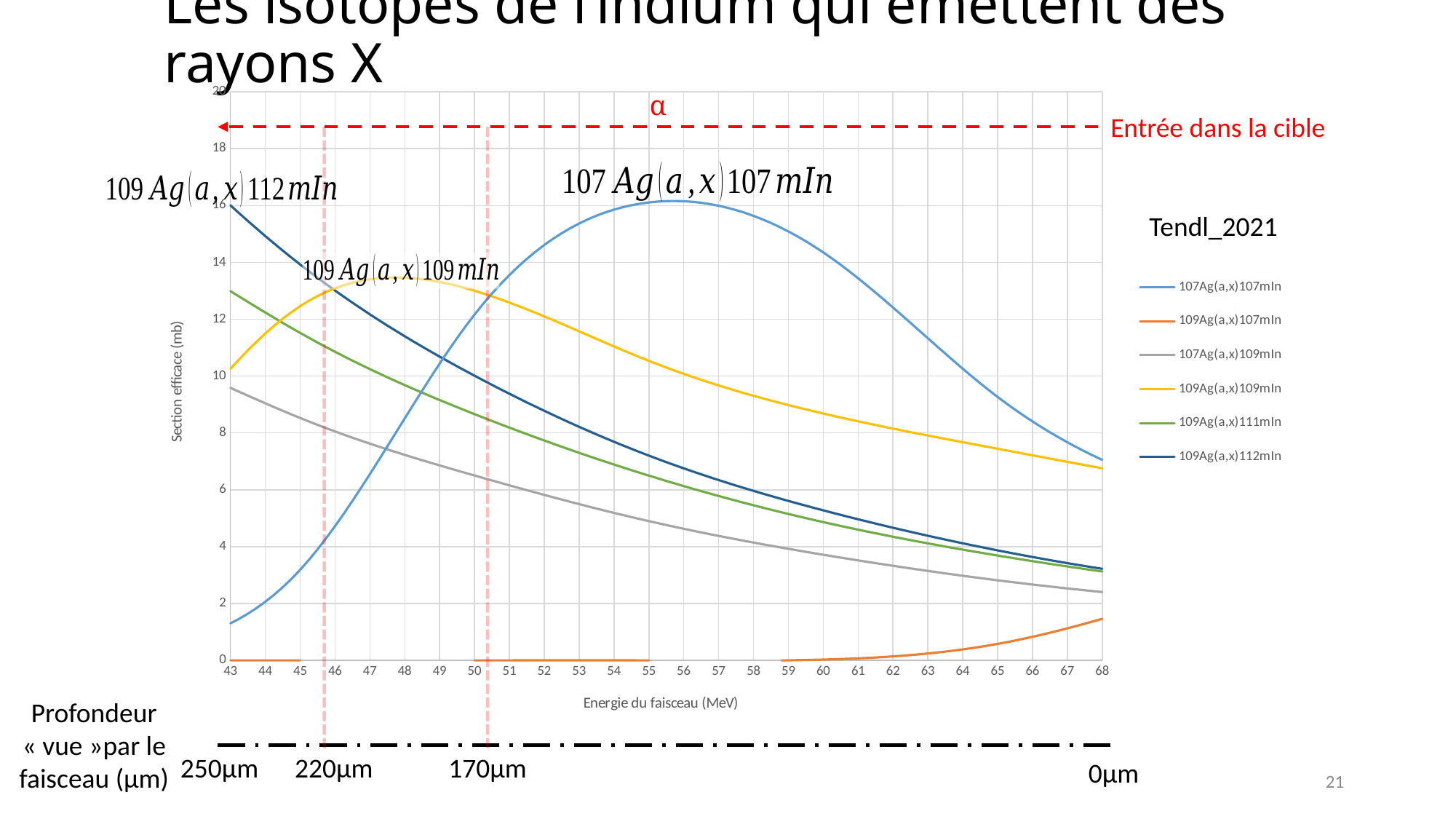
How many series does the chart legend list? 6 Is the value of the 107Ag(a,x)107mIn series at 56 MeV greater or less than 14? greater What is the title of the y axis of the chart? Section efficace (mb) At 60 MeV, which series has the larger value: 107Ag(a,x)107mIn or 109Ag(a,x)109mIn? 107Ag(a,x)107mIn Is the value of the 107Ag(a,x)109mIn series at 43 MeV greater or less than 10? less Is the value of the 109Ag(a,x)107mIn series at 68 MeV greater or less than 2? less What is the title of the x axis of the chart? Energie du faisceau (MeV) Does the 109Ag(a,x)112mIn series rise or fall as the beam energy increases from 43 to 68 MeV? fall Which series has the highest value at 56 MeV? 107Ag(a,x)107mIn At 43 MeV, which series has the larger value: 109Ag(a,x)112mIn or 109Ag(a,x)111mIn? 109Ag(a,x)112mIn What kind of chart is shown on the slide? line chart